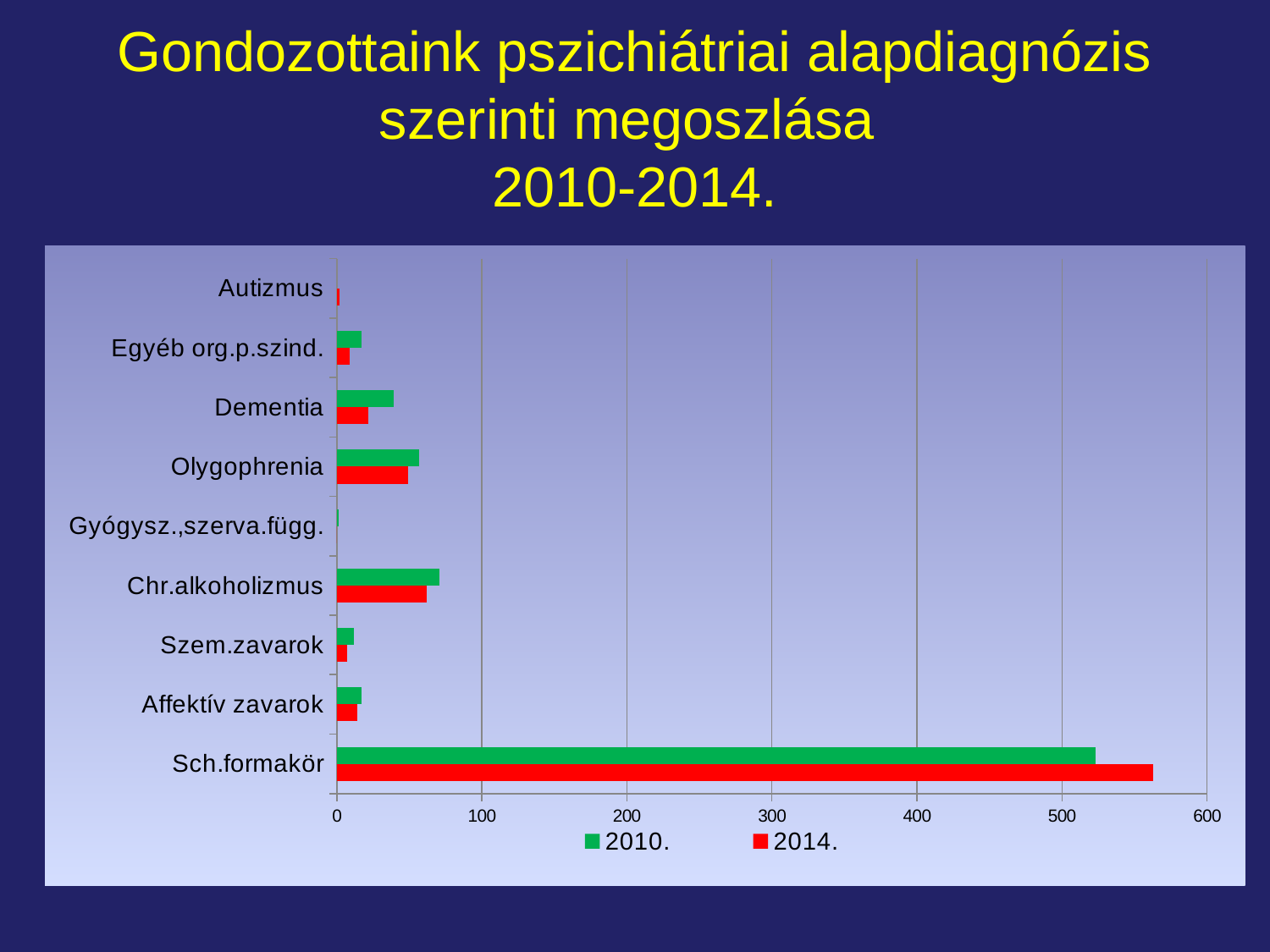
For 2010., which is larger: Chr.alkoholizmus or Olygophrenia? Chr.alkoholizmus Is the 2010. value for Chr.alkoholizmus greater or less than 100? less For Dementia, which is larger: the 2010. value or the 2014. value? 2010. For Sch.formakör, which is larger: the 2010. value or the 2014. value? 2014. Which category has the highest value for 2010.? Sch.formakör Is the 2014. value for Sch.formakör greater or less than 500? greater Which colour represents the 2014. series? red What kind of chart is shown on the slide? bar chart How many series does the legend list? 2 How many diagnosis categories are shown on the chart? 9 Which category has the highest value for 2014.? Sch.formakör What is the highest value shown on the horizontal axis? 600